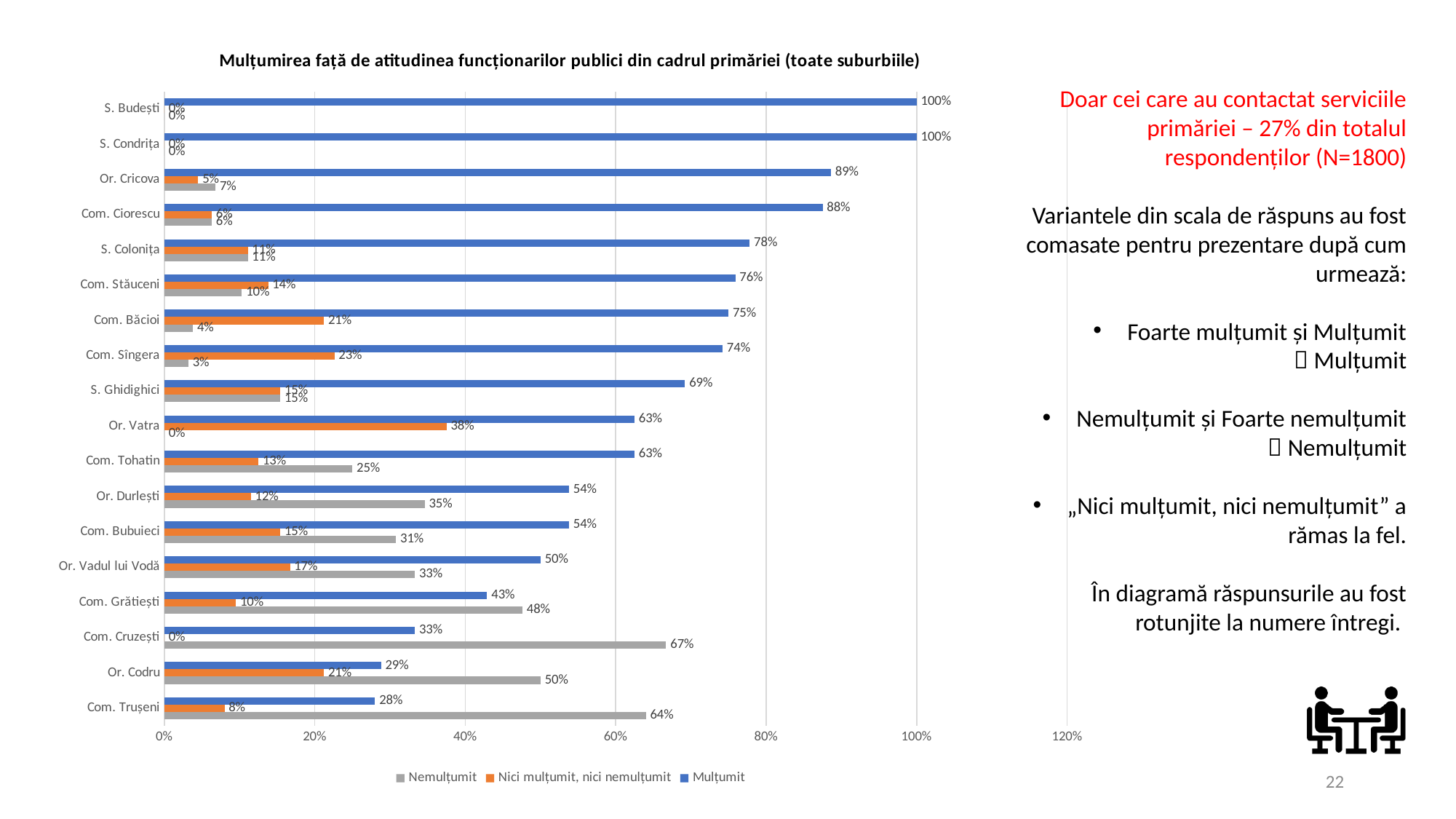
Which colour represents the Mulțumit series in the chart? Blue How many series does the legend list? 3 Which is larger for Com. Grătiești: the Mulțumit value or the Nemulțumit value? Nemulțumit Which locality has the lowest Mulțumit value? Com. Trușeni What is the 'Nici mulțumit, nici nemulțumit' value for Or. Vatra? 38% Which locality has the highest Nemulțumit value? Com. Cruzești How many localities are shown on the chart? 18 What is the Nemulțumit value for Com. Cruzești? 67% What type of chart is shown on the slide? Bar chart Is the Mulțumit value for Com. Stăuceni greater or less than 60%? greater What is the difference between the Mulțumit and Nemulțumit values for Com. Trușeni? 36 percentage points What is the Mulțumit value for Or. Cricova? 89%